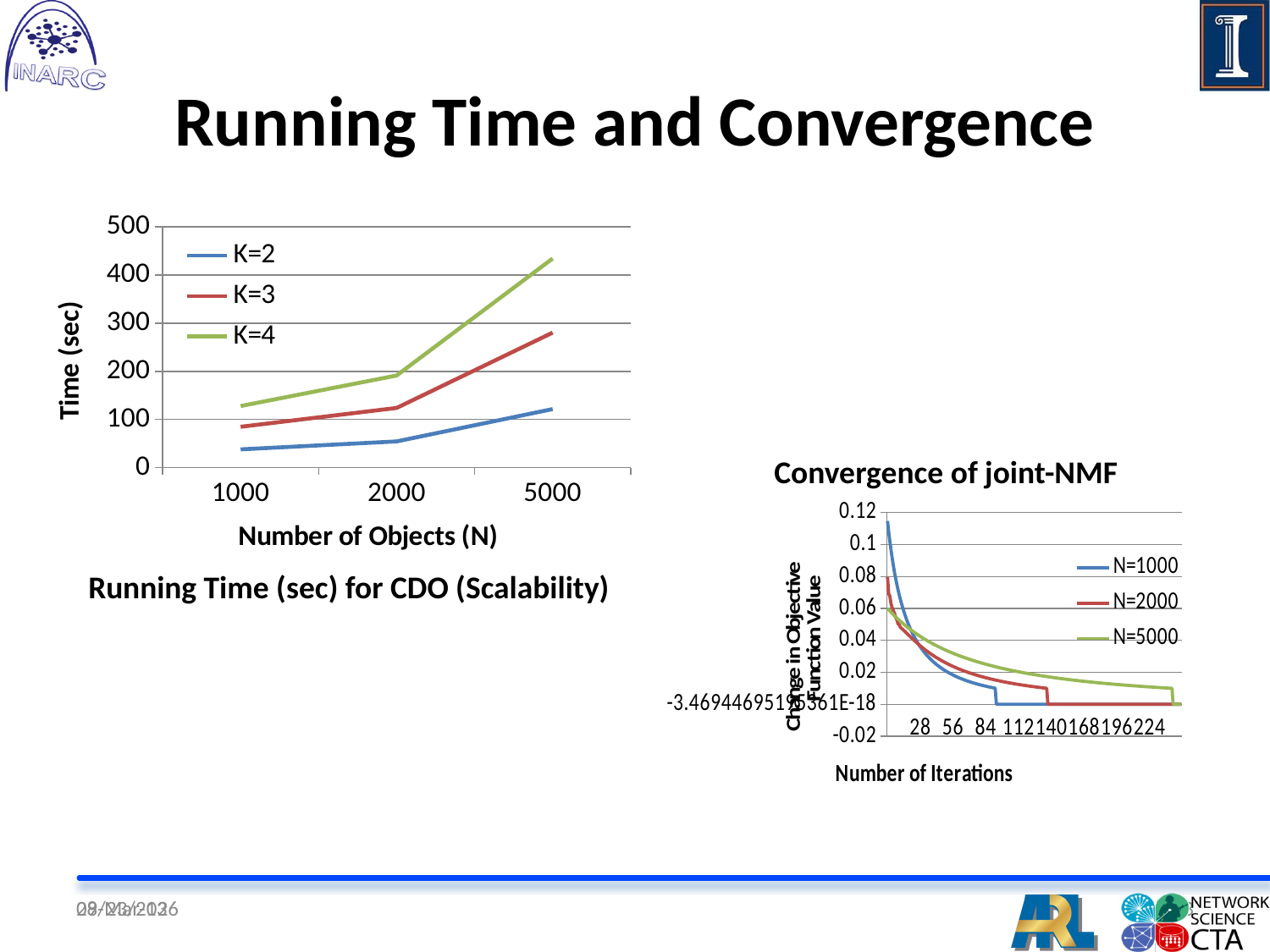
In the Running Time (sec) for CDO (Scalability) chart, is the value for K=4 at N=5000 greater or less than 400? greater In the Running Time (sec) for CDO (Scalability) chart, does the running time for K=3 rise or fall as N increases? rise In the Running Time (sec) for CDO (Scalability) chart, is the value for K=3 at N=5000 greater or less than 300? less How many series does the legend of the Running Time (sec) for CDO (Scalability) chart list? 3 How many series does the legend of the Convergence of joint-NMF chart list? 3 In the Running Time (sec) for CDO (Scalability) chart, is the value for K=2 at N=1000 greater or less than 100? less What type of chart is the Running Time (sec) for CDO (Scalability) chart? line chart In the Running Time (sec) for CDO (Scalability) chart, which series has the lowest running time at N=2000? K=2 What is the x-axis label of the Convergence of joint-NMF chart? Number of Iterations In the Running Time (sec) for CDO (Scalability) chart, which series has the highest running time at N=5000? K=4 In the Running Time (sec) for CDO (Scalability) chart, how many values of N are shown on the x axis? 3